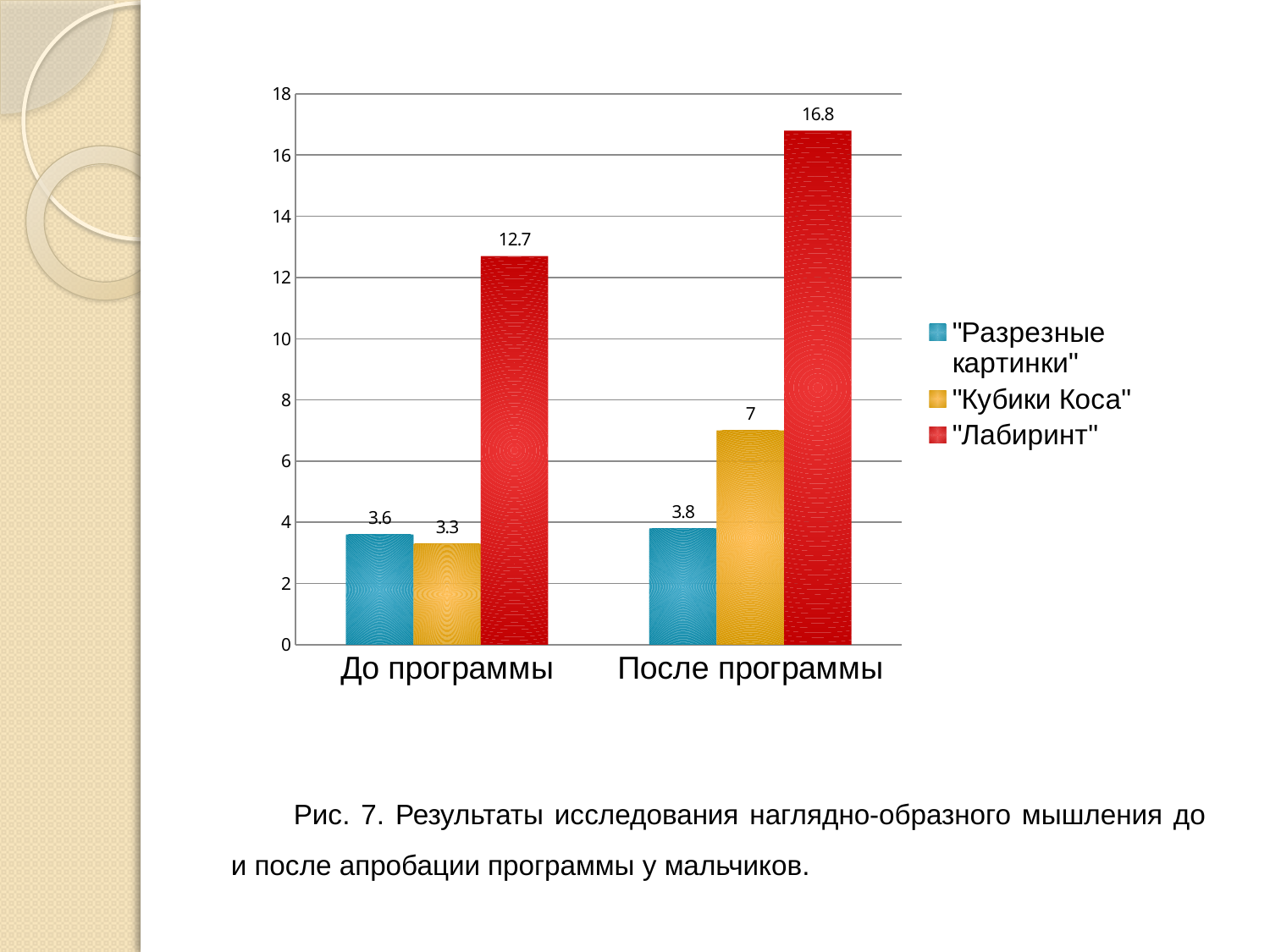
How many categories are shown on the x axis? 2 Which series has the highest value in the "После программы" category? "Лабиринт" Which series has the lowest value in the "До программы" category? "Кубики Коса" What is the value for "Лабиринт" in the "После программы" category? 16.8 What is the value for "Разрезные картинки" in the "До программы" category? 3.6 What kind of chart is shown on the slide? Bar chart What is the value for "Лабиринт" in the "До программы" category? 12.7 How many series does the legend list? 3 Which colour represents the "Лабиринт" series? Red What is the value for "Кубики Коса" in the "После программы" category? 7 What is the difference between the "Лабиринт" values for "После программы" and "До программы"? 4.1 Which is larger: "Кубики Коса" in "До программы" or "Кубики Коса" in "После программы"? "После программы"